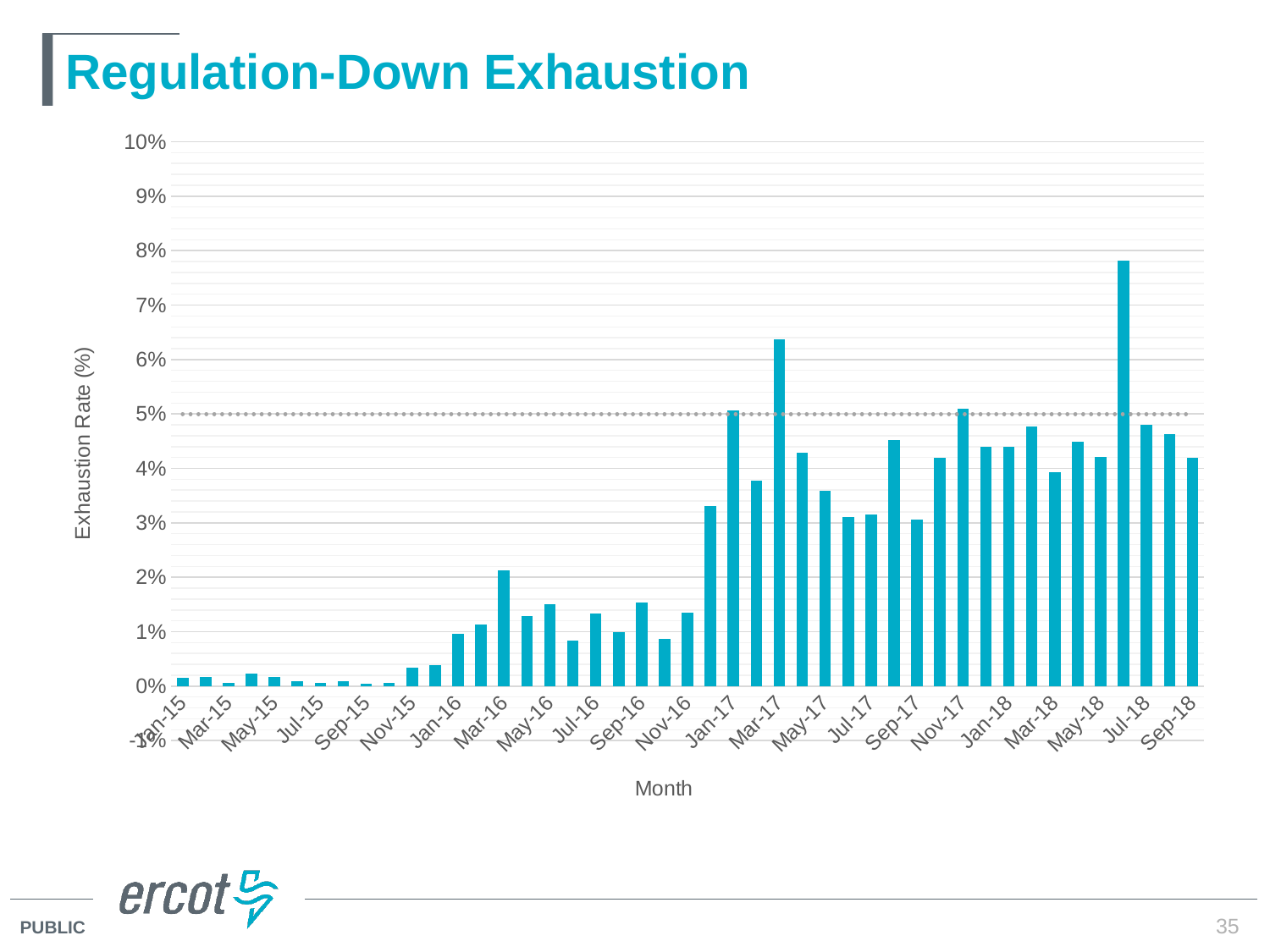
Which has the higher exhaustion rate, Mar-17 or Sep-18? Mar-17 At what level is the horizontal dotted reference line drawn? 5% Overall, do the exhaustion rates rise or fall from Jan-15 to Sep-18? Rise Is the value for Jul-17 greater or less than 4%? less What is the title of the vertical axis? Exhaustion Rate (%) Is the value for Sep-16 greater or less than 1%? greater Which has the higher exhaustion rate, Jan-15 or Jan-17? Jan-17 Is the value for Sep-18 greater or less than 5%? less What kind of chart is shown on the slide? Bar chart Which month has the highest exhaustion rate? Jun-18